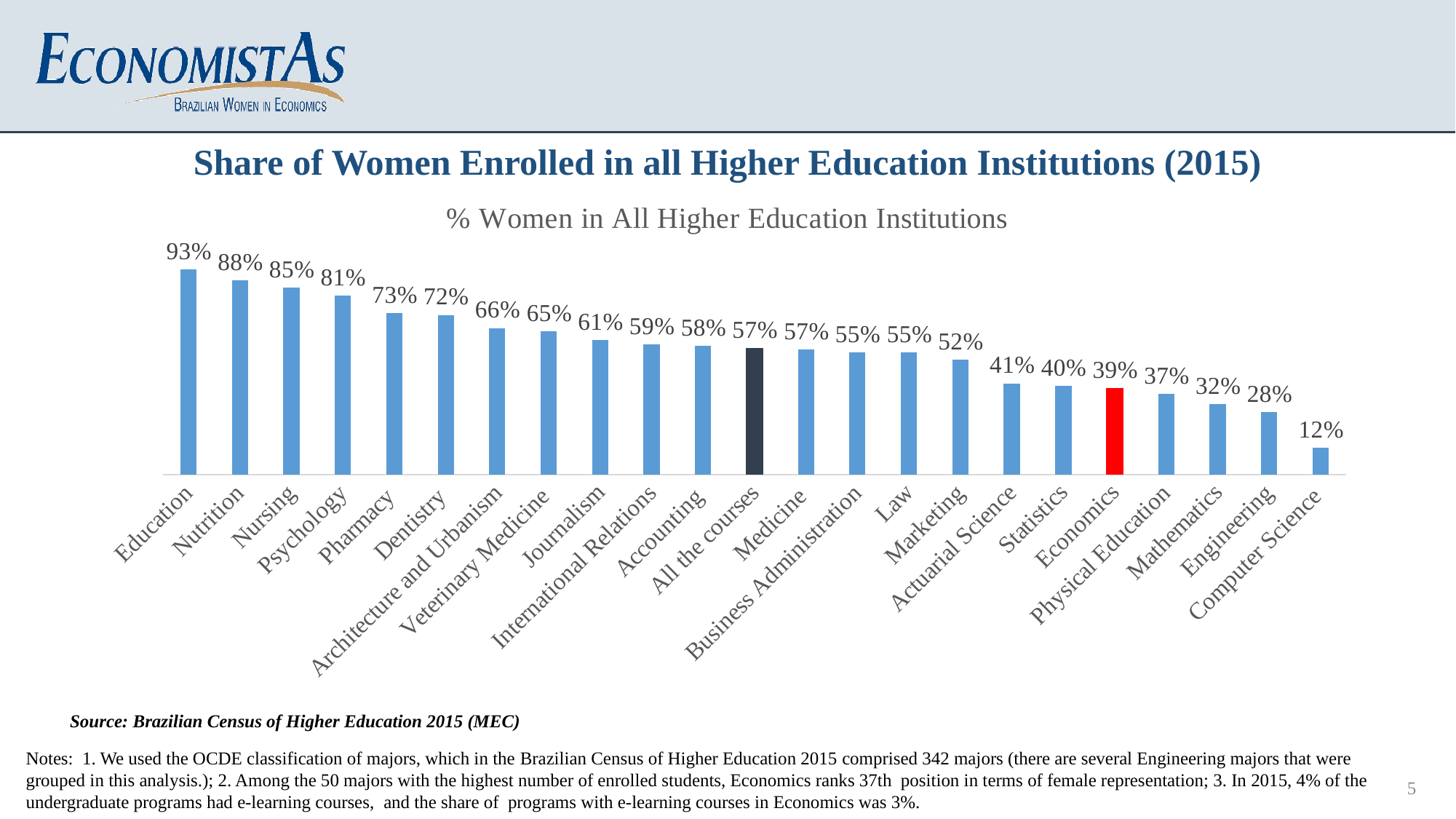
What is the difference between the values for Education and Economics? 54% How many categories are shown in the chart? 23 What is the share of women in Computer Science? 12% Which category's bar is coloured red? Economics What is the value shown for All the courses? 57% Which category has the highest share of women? Education What is the difference between the values for Statistics and Mathematics? 8% What kind of chart is shown on the slide? Bar chart Which has a larger share of women, Pharmacy or Law? Pharmacy What is the value shown for Nursing? 85% What is the share of women enrolled in Economics? 39% Which category has the lowest share of women? Computer Science